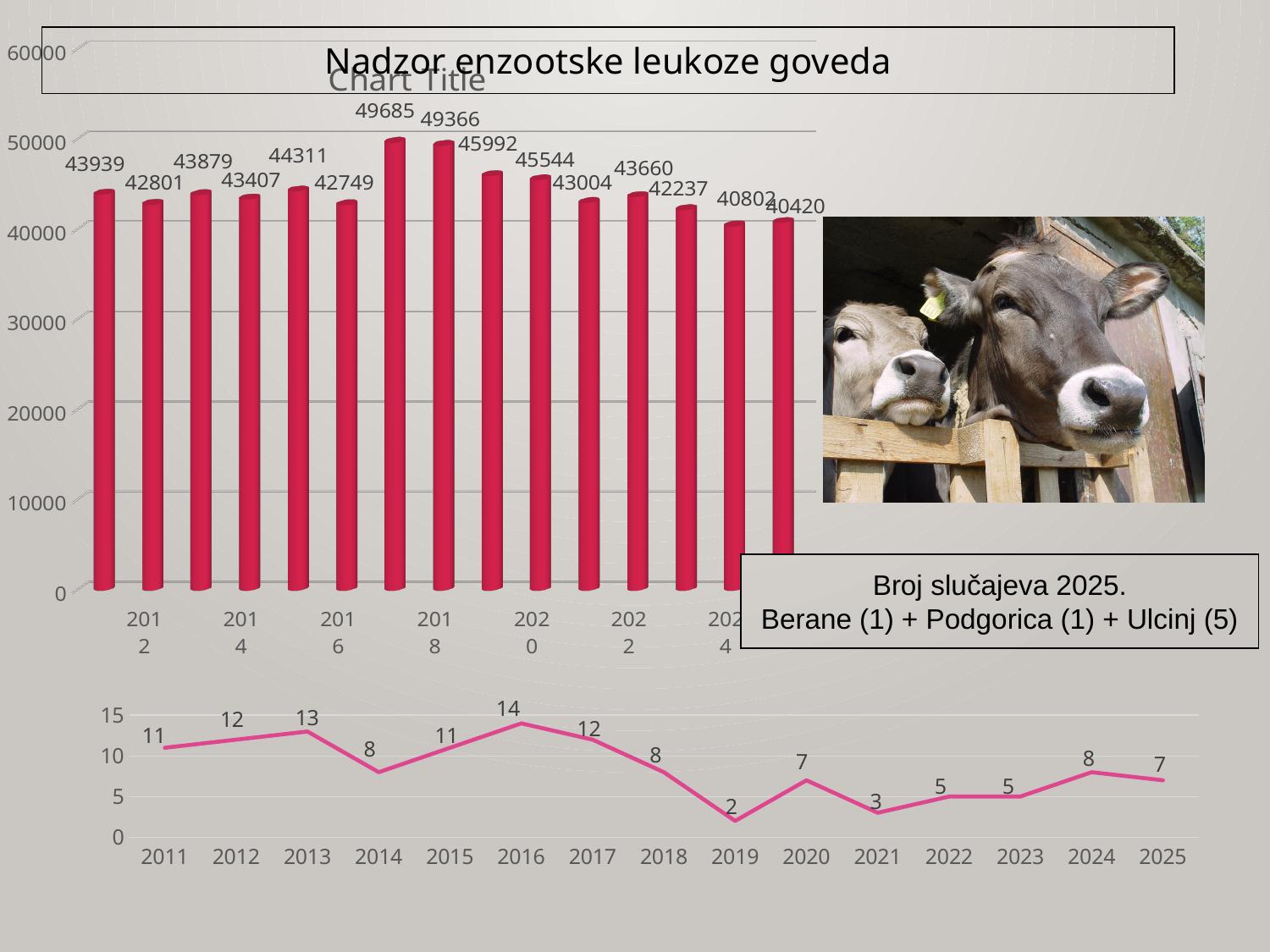
In the top bar chart, what is the value for 2018? 49366 In the bottom line chart, what is the difference between the values for 2011 and 2019? 9 In the top bar chart, what is the difference between the values for 2014 and 2012? 606 In the bottom line chart, which year has the highest value? 2016 In the bottom line chart, how many years are plotted along the x axis? 15 In the bottom line chart, what is the value for 2016? 14 In the top bar chart, what is the value for 2020? 45544 In the top bar chart, what is the lowest value shown? 40420 In the bottom line chart, which year has the larger value, 2013 or 2014? 2013 In the bottom line chart, which year has the lowest value? 2019 What kind of chart is the top chart on the slide? bar chart In the top bar chart, what is the highest value shown? 49685